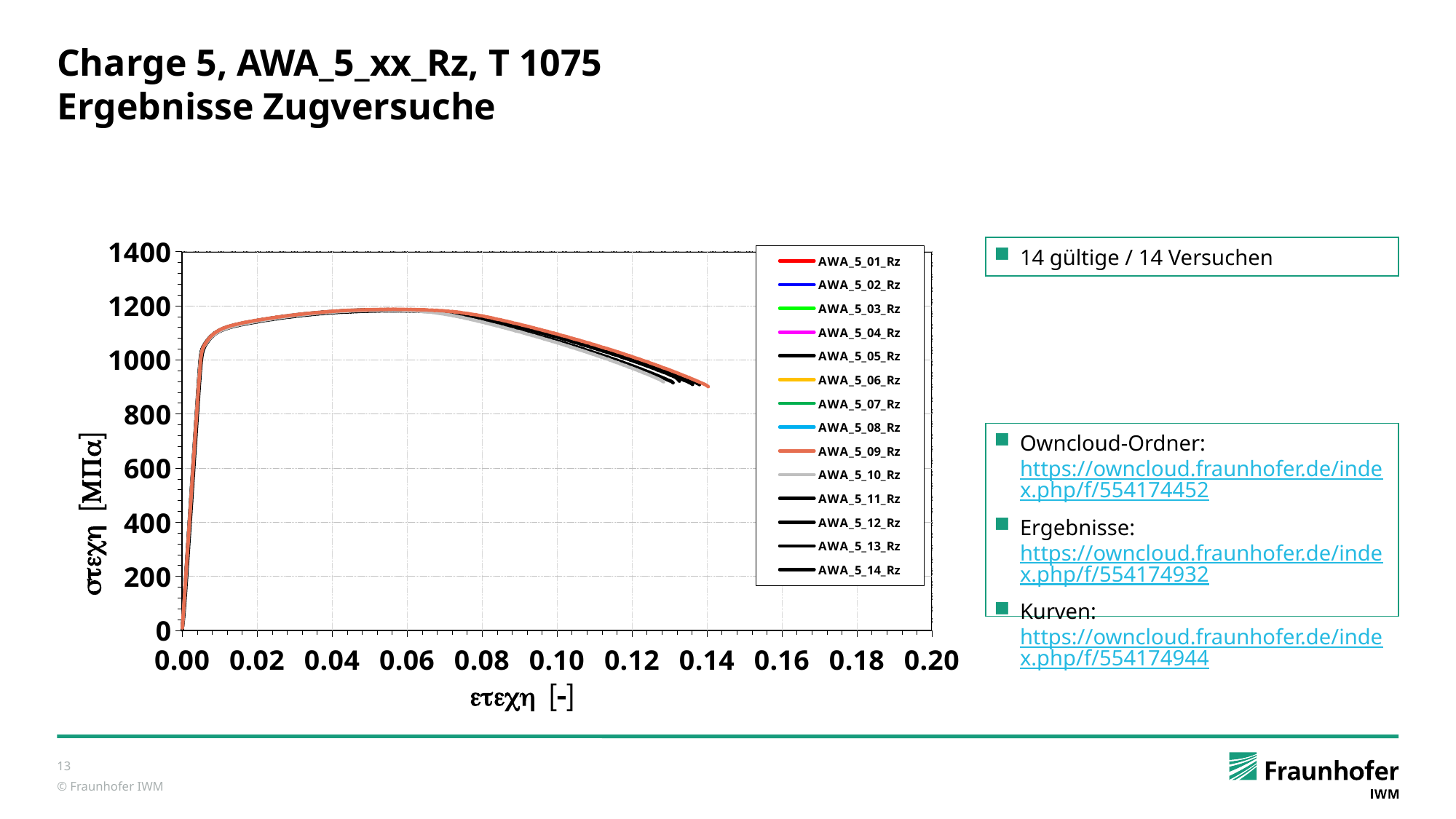
Do the curves rise or fall between a strain of 0.00 and 0.02? rise What is the name of the first series listed in the chart legend? AWA_5_01_Rz Is the peak stress reached by the curves greater or less than 1000? greater What kind of chart is shown on the slide? line chart Is the strain at which the curves end greater or less than 0.10? greater Do the curves rise or fall between a strain of 0.08 and 0.12? fall How many series does the legend of the chart list? 14 Is the stress of the curves at a strain of 0.02 greater or less than 800? greater What is the name of the last series listed in the chart legend? AWA_5_14_Rz